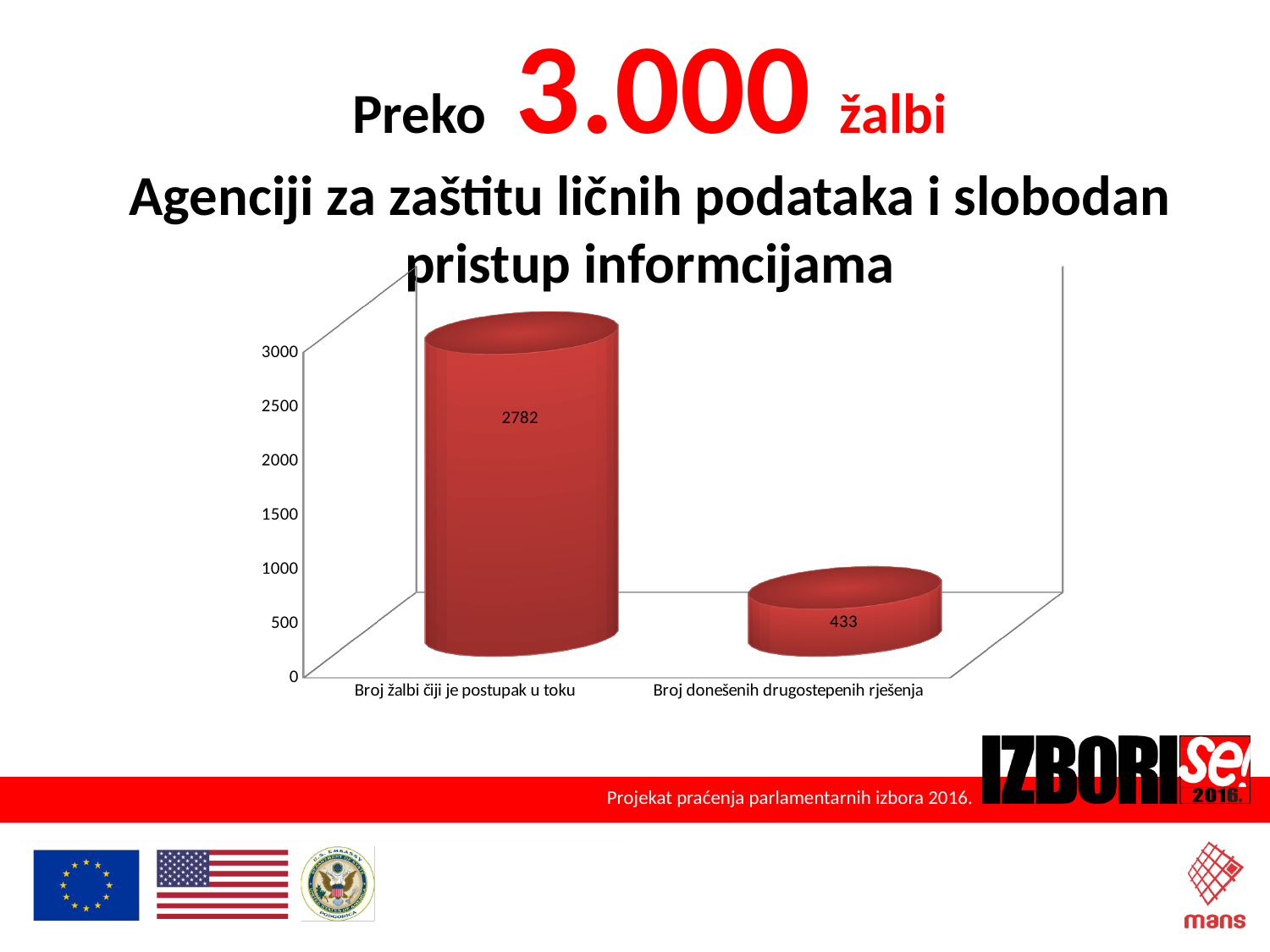
How many categories are shown in the chart? 2 What is the total of the two values shown in the chart? 3215 Is the value for "Broj žalbi čiji je postupak u toku" greater or less than 2500? greater What is the highest value shown on the vertical axis of the chart? 3000 What kind of chart is shown on the slide? bar chart What is the value for "Broj žalbi čiji je postupak u toku"? 2782 What is the value for "Broj donešenih drugostepenih rješenja"? 433 Which category has the highest value? Broj žalbi čiji je postupak u toku What is the difference between the value for "Broj žalbi čiji je postupak u toku" and the value for "Broj donešenih drugostepenih rješenja"? 2349 Is the value for "Broj donešenih drugostepenih rješenja" greater or less than 1000? less Which category has the lowest value? Broj donešenih drugostepenih rješenja Which is larger: the value for "Broj žalbi čiji je postupak u toku" or the value for "Broj donešenih drugostepenih rješenja"? Broj žalbi čiji je postupak u toku